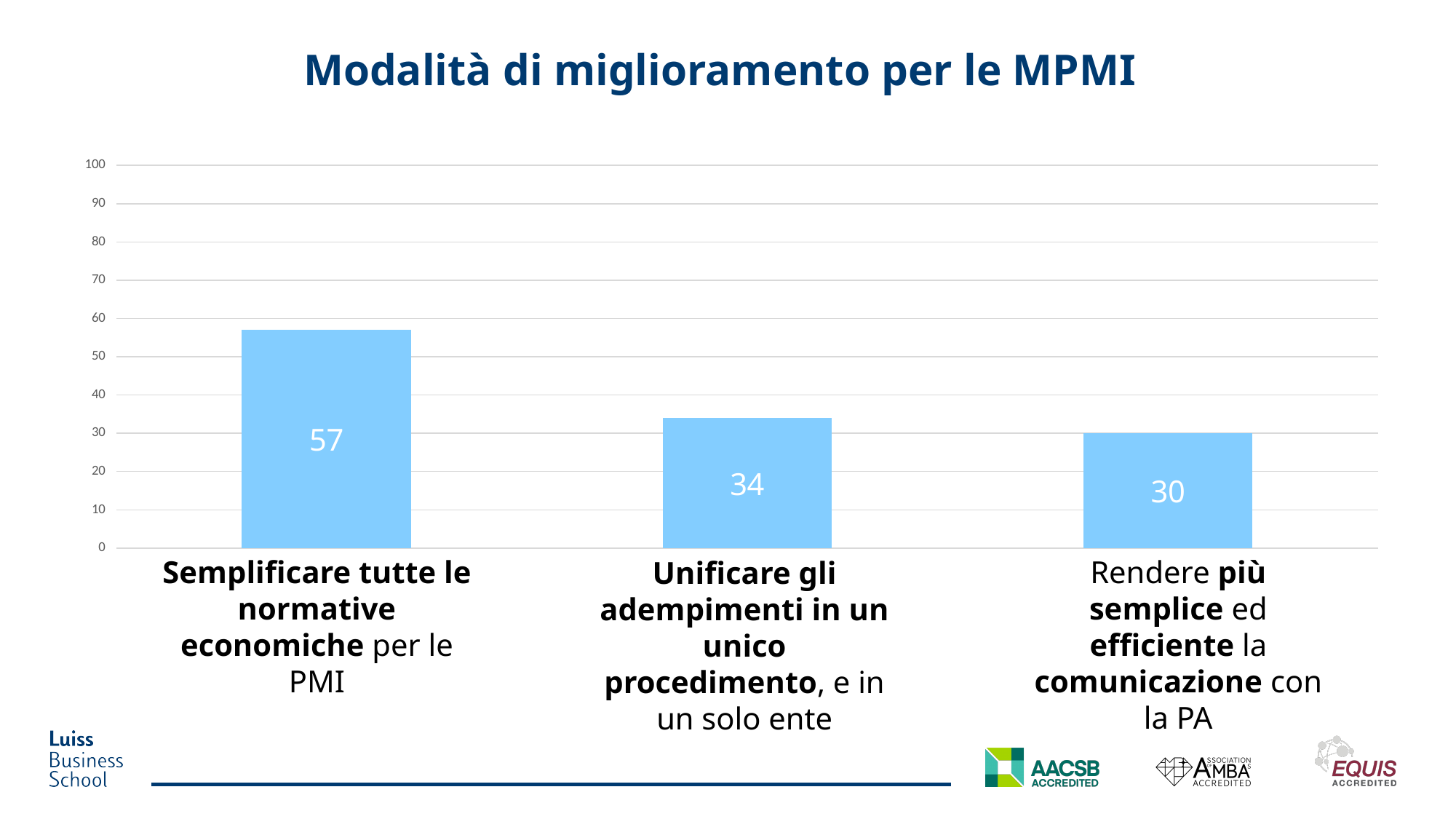
How many categories are shown in the chart? 3 What is the value for "Rendere più semplice ed efficiente la comunicazione con la PA"? 30 What is the difference between the values for "Semplificare tutte le normative economiche per le PMI" and "Unificare gli adempimenti in un unico procedimento, e in un solo ente"? 23 What kind of chart is shown on the slide? Bar chart What is the title of the chart? Modalità di miglioramento per le MPMI Which is larger: the value for "Semplificare tutte le normative economiche per le PMI" or the value for "Rendere più semplice ed efficiente la comunicazione con la PA"? Semplificare tutte le normative economiche per le PMI What is the difference between the values for "Unificare gli adempimenti in un unico procedimento, e in un solo ente" and "Rendere più semplice ed efficiente la comunicazione con la PA"? 4 Which category has the lowest value? Rendere più semplice ed efficiente la comunicazione con la PA Is the value for "Semplificare tutte le normative economiche per le PMI" greater or less than 50? greater Which category has the highest value? Semplificare tutte le normative economiche per le PMI What is the value for "Semplificare tutte le normative economiche per le PMI"? 57 What is the value for "Unificare gli adempimenti in un unico procedimento, e in un solo ente"? 34